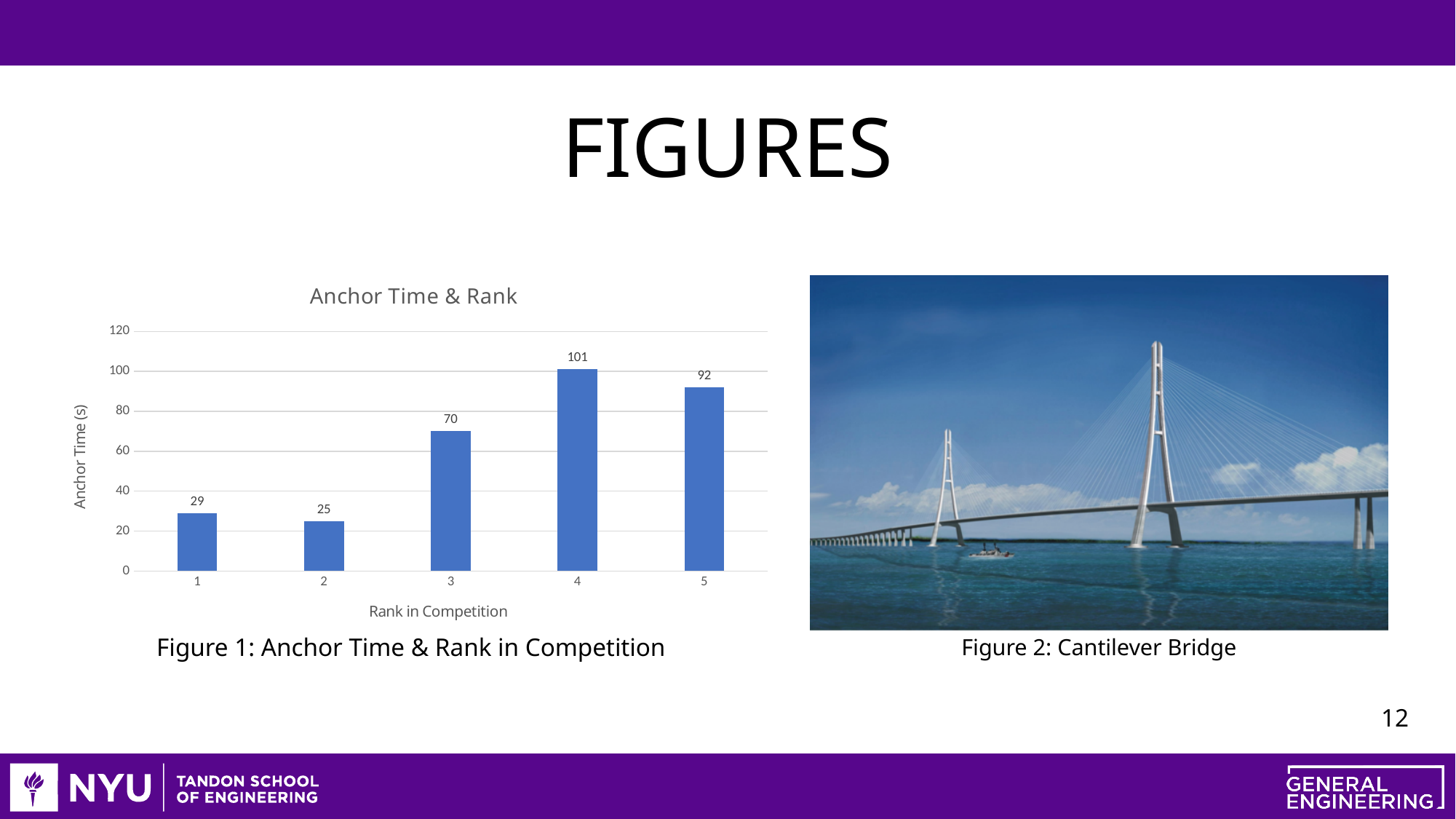
Is the anchor time for rank 3 greater or less than 80 in the Anchor Time & Rank chart? less What is the difference in anchor time between rank 3 and rank 2 in the Anchor Time & Rank chart? 45 Which rank has the highest anchor time in the Anchor Time & Rank chart? 4 Which rank has the lowest anchor time in the Anchor Time & Rank chart? 2 What is the anchor time for rank 5 in the Anchor Time & Rank chart? 92 What is the anchor time for rank 1 in the Anchor Time & Rank chart? 29 What is the anchor time for rank 4 in the Anchor Time & Rank chart? 101 What is the label of the vertical axis in the Anchor Time & Rank chart? Anchor Time (s) How many ranks are plotted in the Anchor Time & Rank chart? 5 In the Anchor Time & Rank chart, which has a larger anchor time, rank 1 or rank 2? rank 1 What is the difference in anchor time between rank 4 and rank 5 in the Anchor Time & Rank chart? 9 What kind of chart is the Anchor Time & Rank chart? bar chart